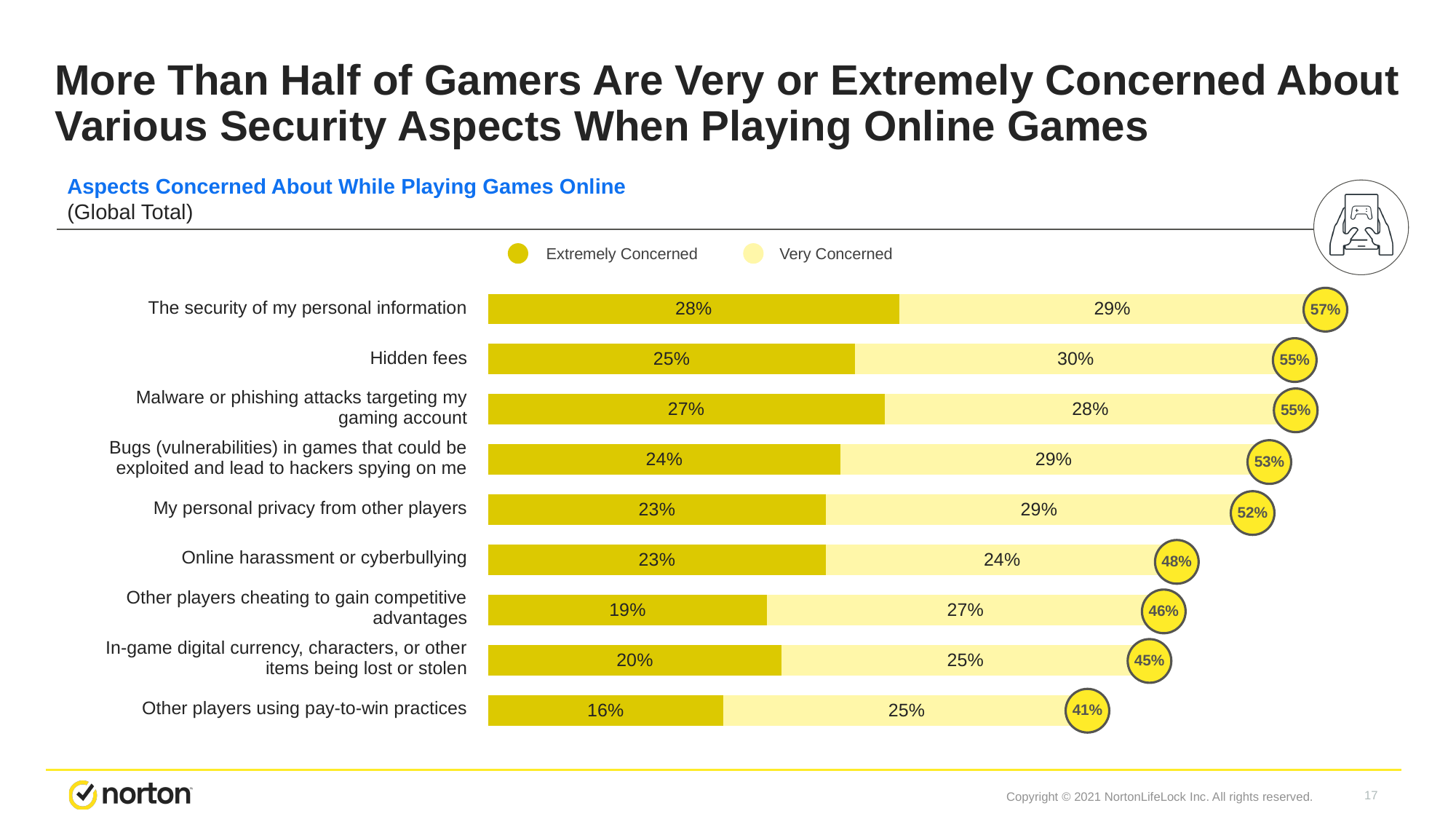
What is the combined total shown for 'Online harassment or cyberbullying'? 48% How many aspects (categories) are shown in the chart? 9 What is the title of the chart? Aspects Concerned About While Playing Games Online What is the difference between the Extremely Concerned values for 'Hidden fees' and 'Other players using pay-to-win practices'? 9% How many series does the legend list? 2 What kind of chart is shown on the slide? Stacked bar chart Which aspect has the highest combined total of Extremely and Very Concerned? The security of my personal information Which is larger: the Extremely Concerned value for 'Malware or phishing attacks targeting my gaming account' or for 'My personal privacy from other players'? Malware or phishing attacks targeting my gaming account What percentage of gamers are Extremely Concerned about the security of their personal information? 28% What is the Extremely Concerned value for 'Other players using pay-to-win practices'? 16% What percentage of gamers are Very Concerned about hidden fees? 30% Which aspect has the lowest combined total of Extremely and Very Concerned? Other players using pay-to-win practices